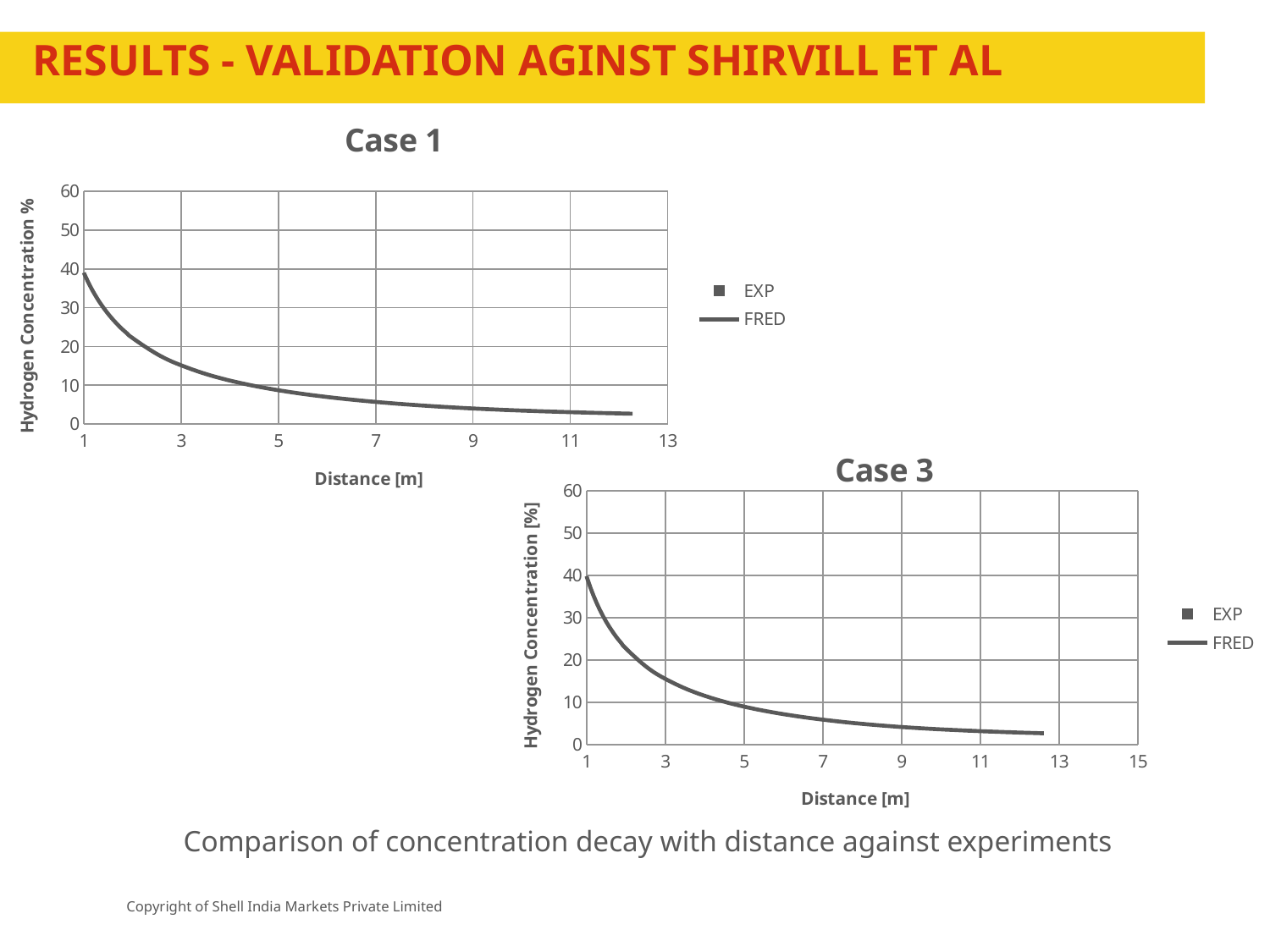
In the Case 3 chart, does the FRED line rise or fall along the x axis? fall What kind of chart is the Case 1 chart? line chart How many series does the legend of the Case 3 chart list? 2 In the Case 3 chart, is the FRED value at a distance of 1 m greater or less than 30? greater In the Case 3 chart, is the FRED value at a distance of 3 m greater or less than 20? less In the Case 1 chart, is the FRED value at a distance of 7 m greater or less than 10? less What is the y-axis title of the Case 1 chart? Hydrogen Concentration % In the Case 1 chart, does the FRED line rise or fall as distance increases? fall What are the two legend entries in the Case 1 chart? EXP and FRED